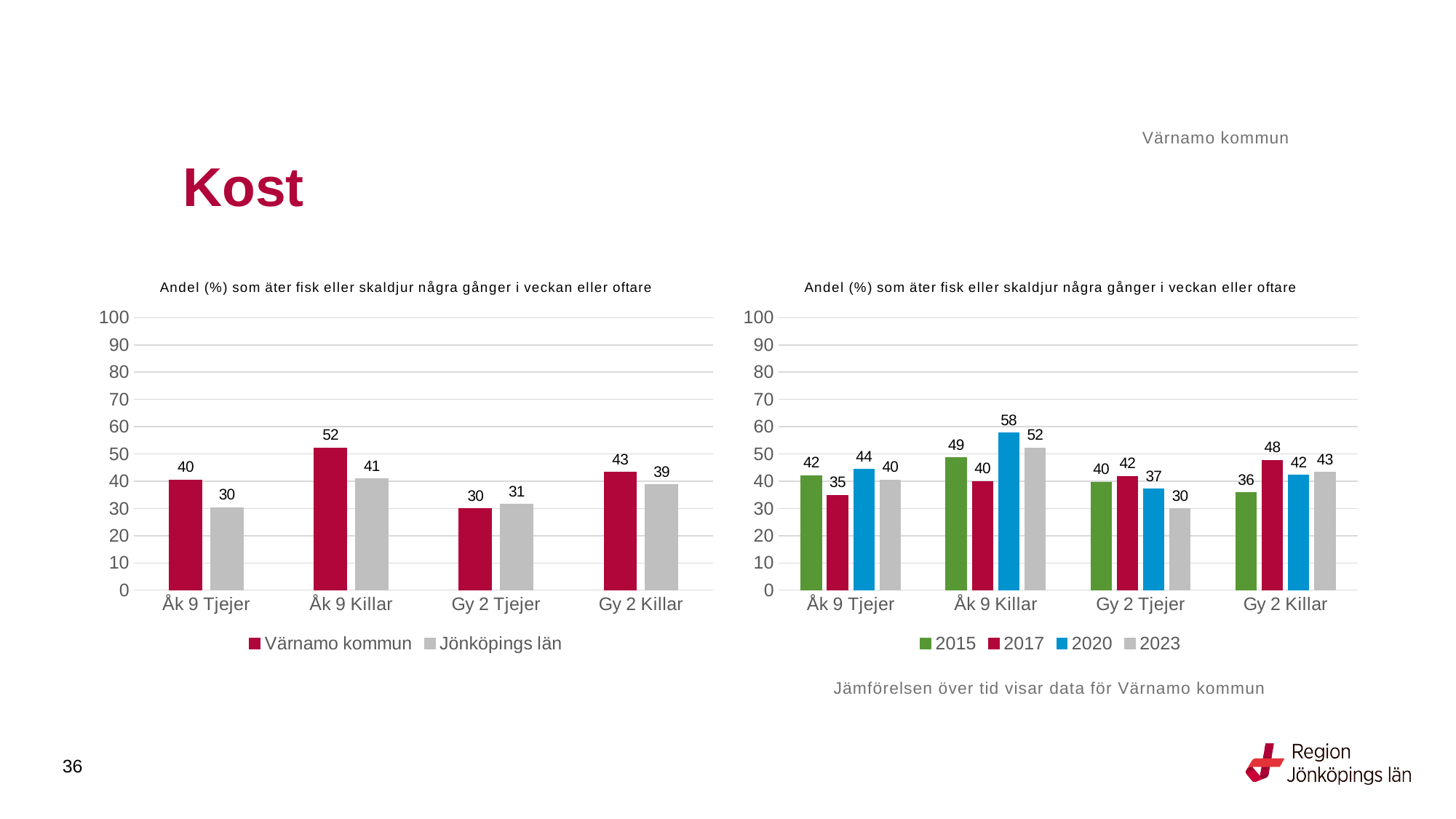
In the right chart, what is the value for 2020 for Åk 9 Killar? 58 In the right chart, which is larger for Gy 2 Tjejer: the value for 2015 or the value for 2023? 2015 In the left chart, how many series does the legend list? 2 In the right chart, how many categories are shown on the x axis? 4 In the right chart, what is the value for 2017 for Gy 2 Killar? 48 In the left chart, which category has the lowest value for Värnamo kommun? Gy 2 Tjejer In the left chart, what is the difference between Värnamo kommun and Jönköpings län for Åk 9 Tjejer? 10 In the left chart, what is the value for Jönköpings län for Gy 2 Tjejer? 31 In the right chart, which category has the highest value for 2015? Åk 9 Killar In the left chart, what is the value for Värnamo kommun for Åk 9 Killar? 52 What kind of chart is the left chart? Bar chart In the right chart, how many series does the legend list? 4